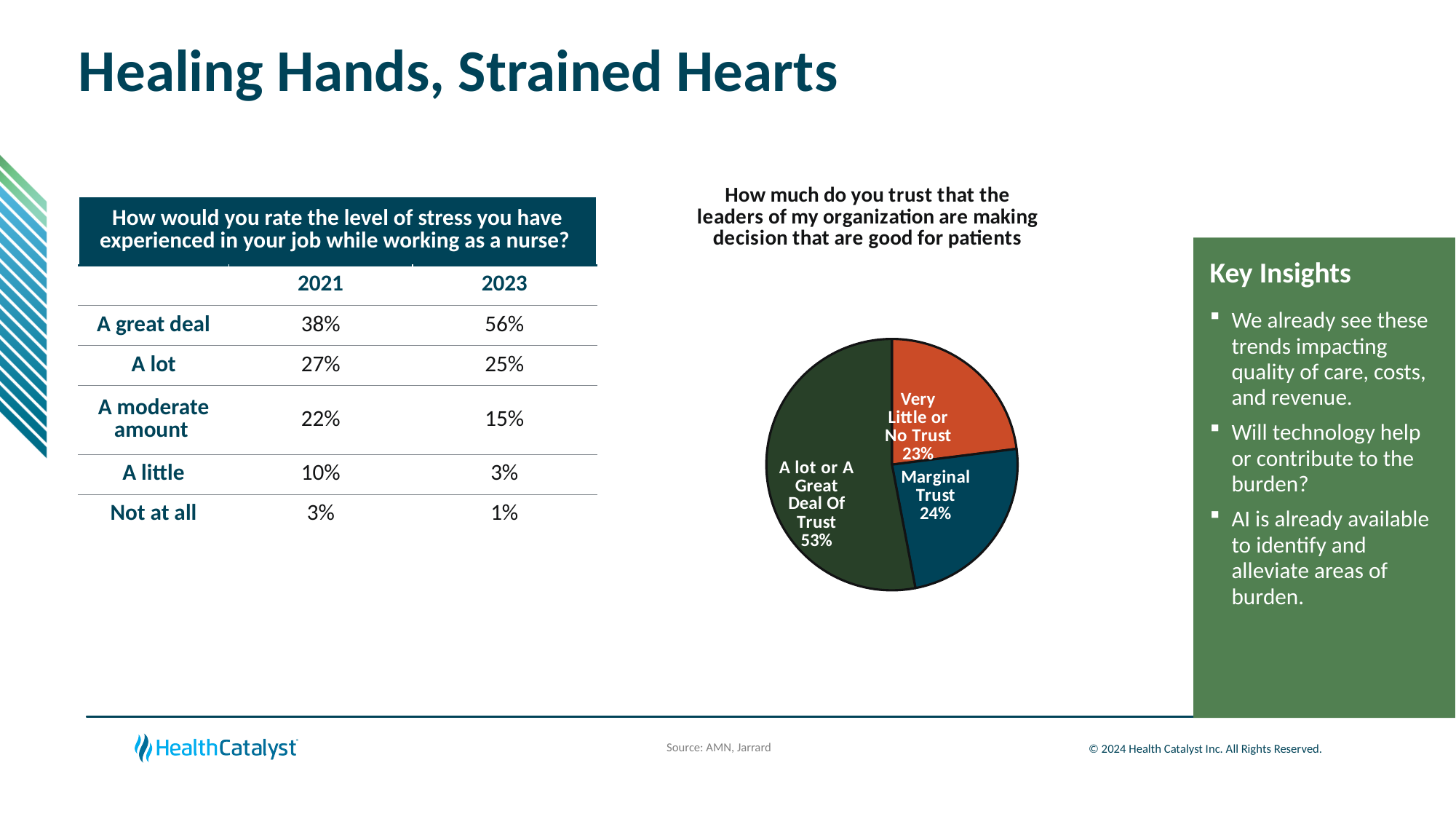
In the trust pie chart, what percentage is shown for "Very Little or No Trust"? 23% In the trust pie chart, what percentage is shown for "Marginal Trust"? 24% In the trust pie chart, which slice is the smallest? Very Little or No Trust In the trust pie chart, what is the combined share of "Very Little or No Trust" and "Marginal Trust"? 47% In the trust pie chart, which is larger: "Marginal Trust" or "Very Little or No Trust"? Marginal Trust In the trust pie chart, how many percentage points larger is "A lot or A Great Deal Of Trust" than "Marginal Trust"? 29 percentage points In the trust pie chart, is the share for "A lot or A Great Deal Of Trust" greater or less than 50%? greater What kind of chart is shown under the title "How much do you trust that the leaders of my organization are making decision that are good for patients"? Pie chart How many slices does the trust pie chart have? 3 In the trust pie chart, what share of respondents reported "A lot or A Great Deal Of Trust"? 53% In the trust pie chart, which slice is the largest? A lot or A Great Deal Of Trust In the trust pie chart, what colour is the "Very Little or No Trust" slice? Orange